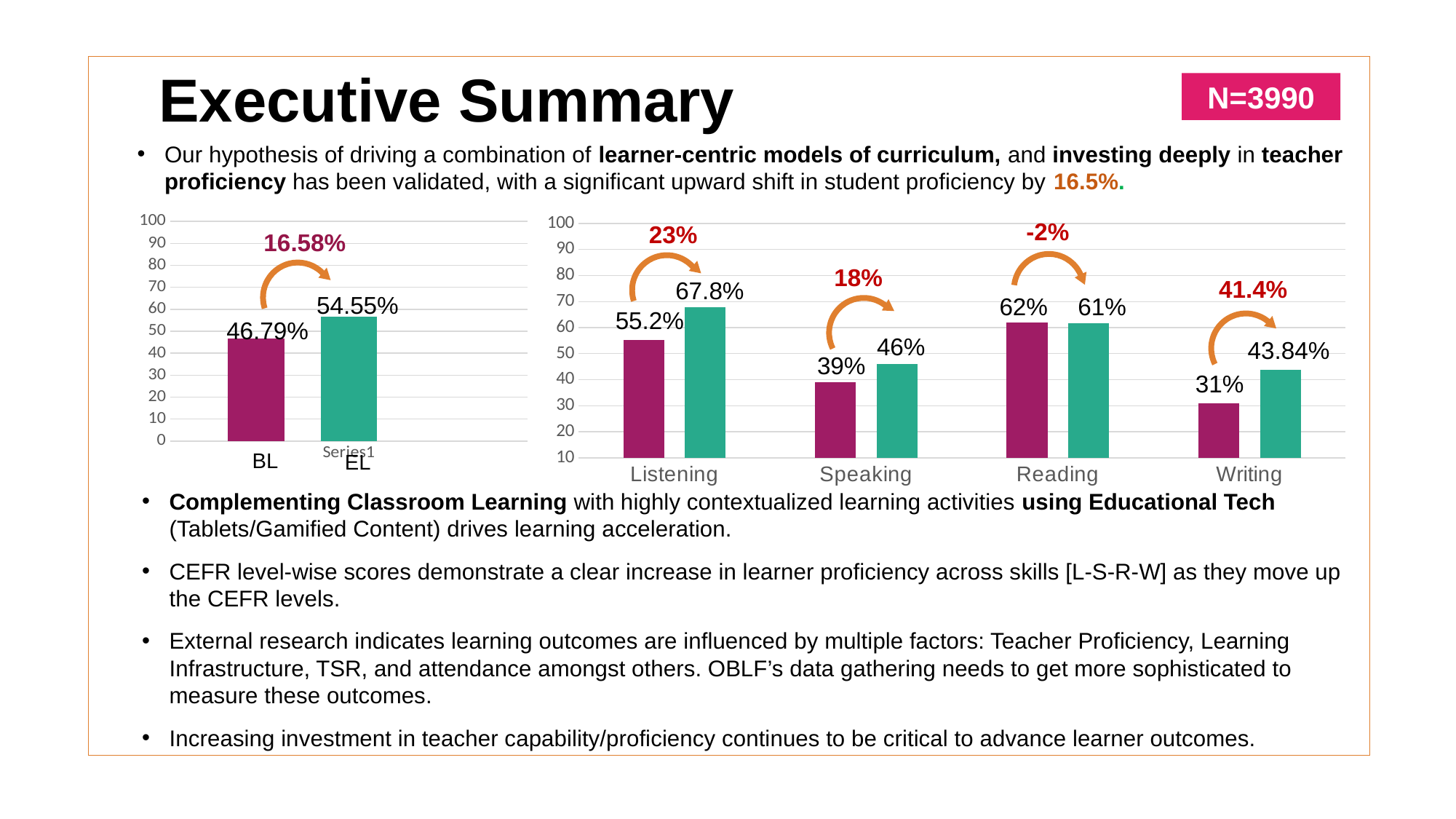
In the right chart, how many skill categories are shown on the x axis? 4 In the right chart, what is the value of the magenta bar for Listening? 55.2% In the right chart, what is the value of the teal bar for Writing? 43.84% In the left chart, what is the value for EL? 54.55% In the left chart, what is the value for BL? 46.79% In the right chart, which category has the highest teal bar? Listening In the left chart, what percentage change is written above the arrow between BL and EL? 16.58% In the right chart, which category has the lowest magenta bar? Writing In the right chart, what is the difference between the teal and magenta bars for Speaking? 7% In the left chart, what is the difference between the EL and BL values? 7.76% In the right chart, which is larger for Reading: the magenta bar or the teal bar? The magenta bar (62%) What type of chart is the right chart? Bar chart